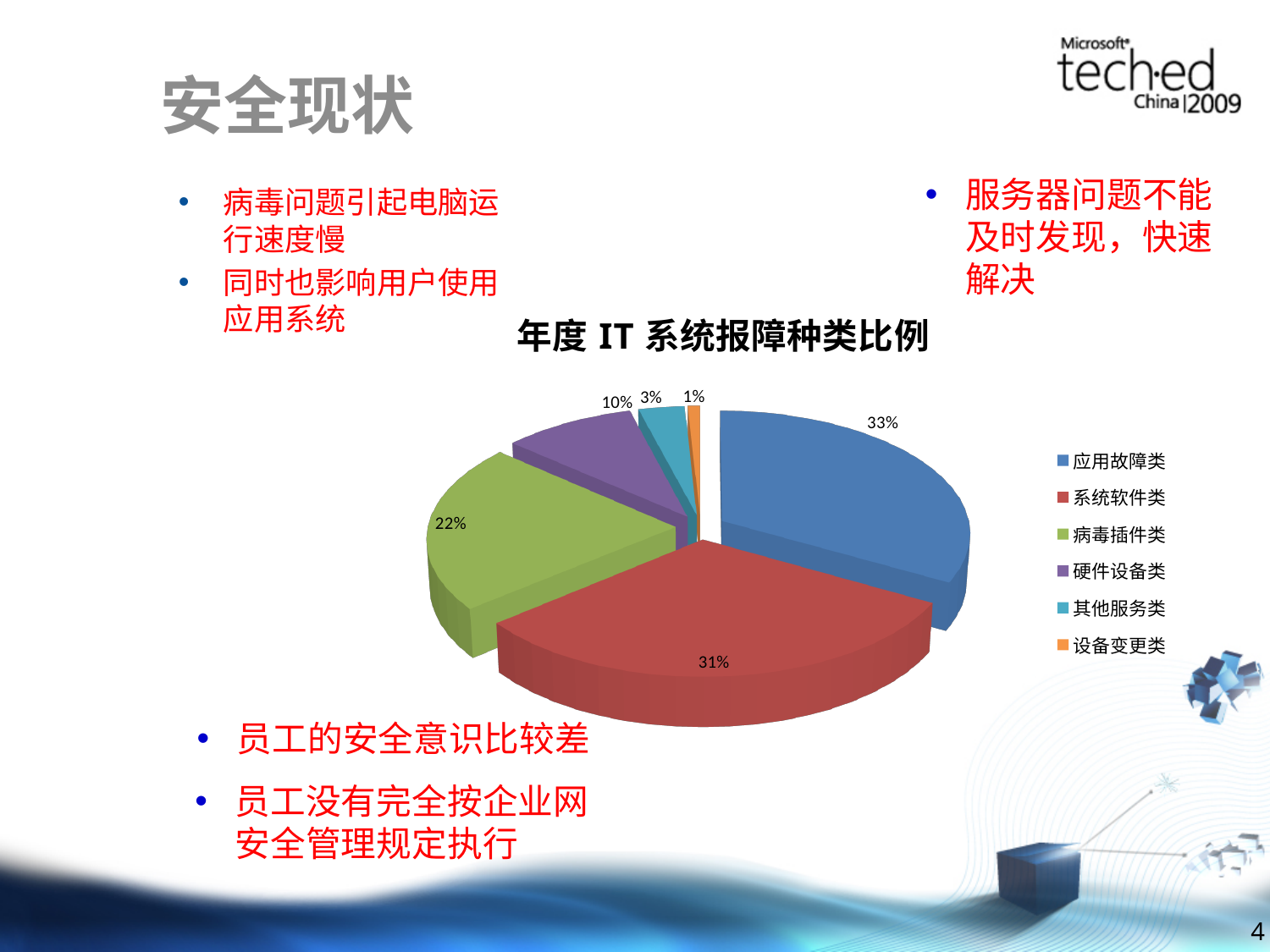
Which is larger, the share for 其他服务类 or the share for 硬件设备类? 硬件设备类 Which category has the smallest slice of the pie? 设备变更类 What is the difference in percentage points between 病毒插件类 and 硬件设备类? 12 What share of the pie does 设备变更类 represent? 1% Which category has the largest slice of the pie? 应用故障类 What type of chart is shown on the slide? Pie chart How many categories does the legend list? 6 What share of the pie does 应用故障类 represent? 33% What is the title of the chart? 年度 IT 系统报障种类比例 What share of the pie does 病毒插件类 represent? 22%